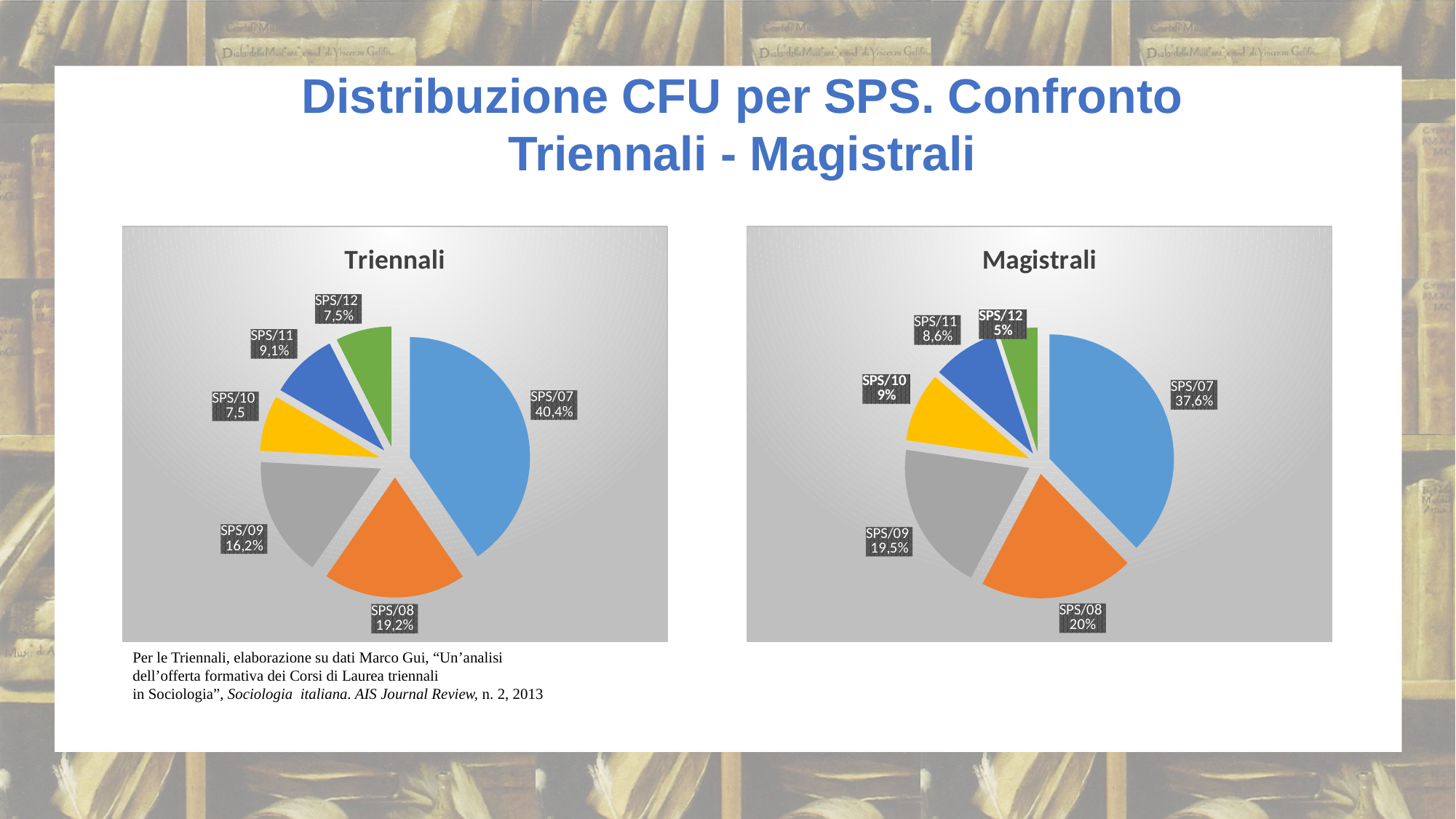
In the Magistrali chart, what share does SPS/10 have? 9% What colour is the SPS/08 slice in the Triennali chart? Orange In the Magistrali chart, what is the difference between the shares of SPS/07 and SPS/08? 17,6% In the Triennali chart, what share does SPS/11 have? 9,1% In the Triennali chart, which is larger, the share of SPS/08 or the share of SPS/09? SPS/08 In the Triennali chart, which category has the largest slice? SPS/07 In the Magistrali chart, what share does SPS/09 have? 19,5% In the Magistrali chart, what share does SPS/12 have? 5% In the Triennali chart, what share does SPS/07 have? 40,4% How many categories are shown in the Magistrali chart? 6 In the Magistrali chart, which category has the smallest slice? SPS/12 What kind of chart is the Triennali chart? Pie chart